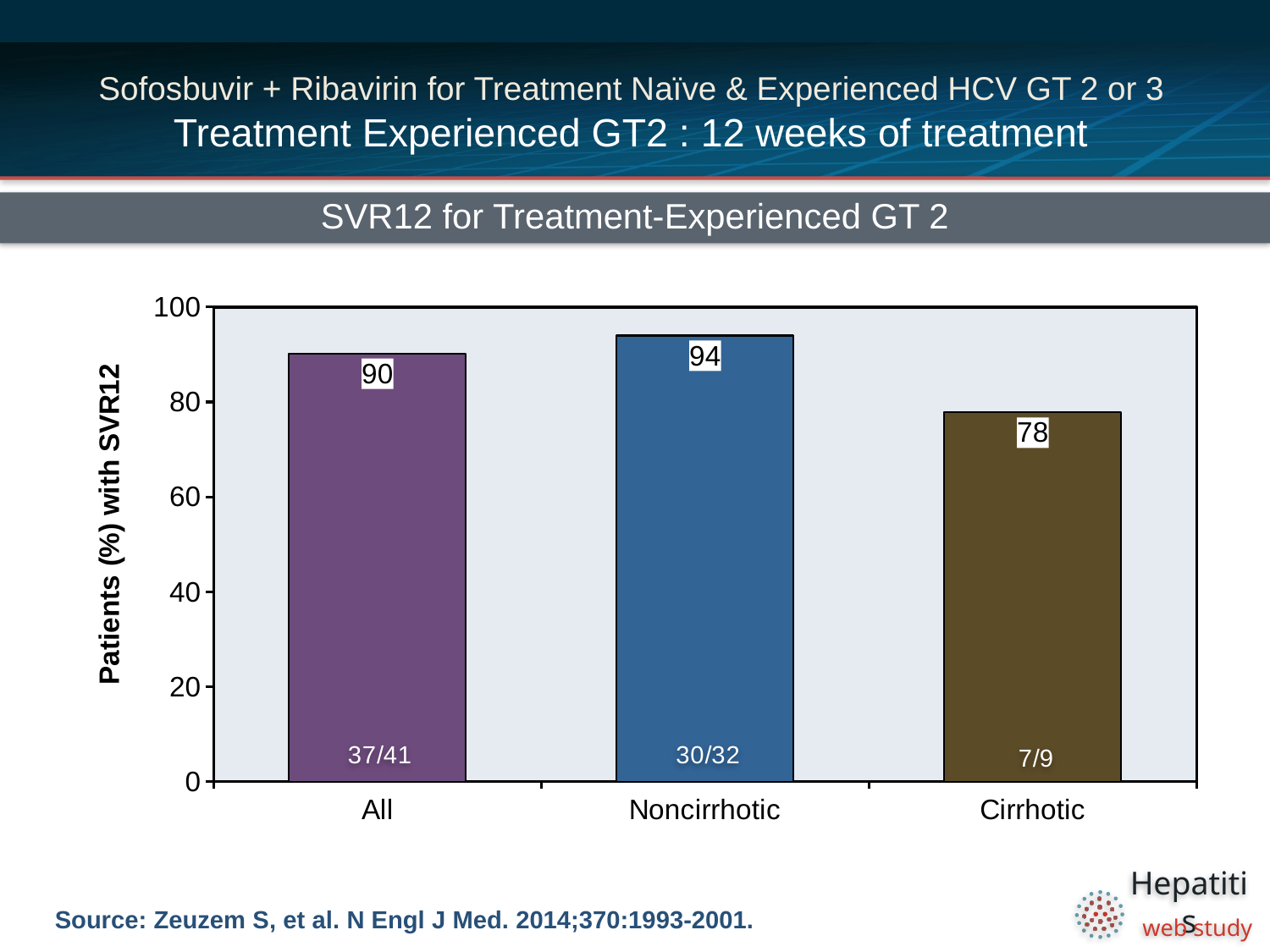
How many groups are shown on the x axis? 3 What is the difference between the SVR12 values for Noncirrhotic and Cirrhotic? 16 Which has a higher SVR12 value, All or Cirrhotic? All What is the SVR12 value for the Cirrhotic group? 78 Which group has the highest SVR12 value? Noncirrhotic Is the value for Cirrhotic greater or less than 80? less What is the SVR12 value for the Noncirrhotic group? 94 What is the title of the chart? SVR12 for Treatment-Experienced GT 2 What fraction of patients is printed inside the Cirrhotic bar? 7/9 What is the SVR12 value for the All group? 90 What kind of chart is shown on the slide? Bar chart Which group has the lowest SVR12 value? Cirrhotic